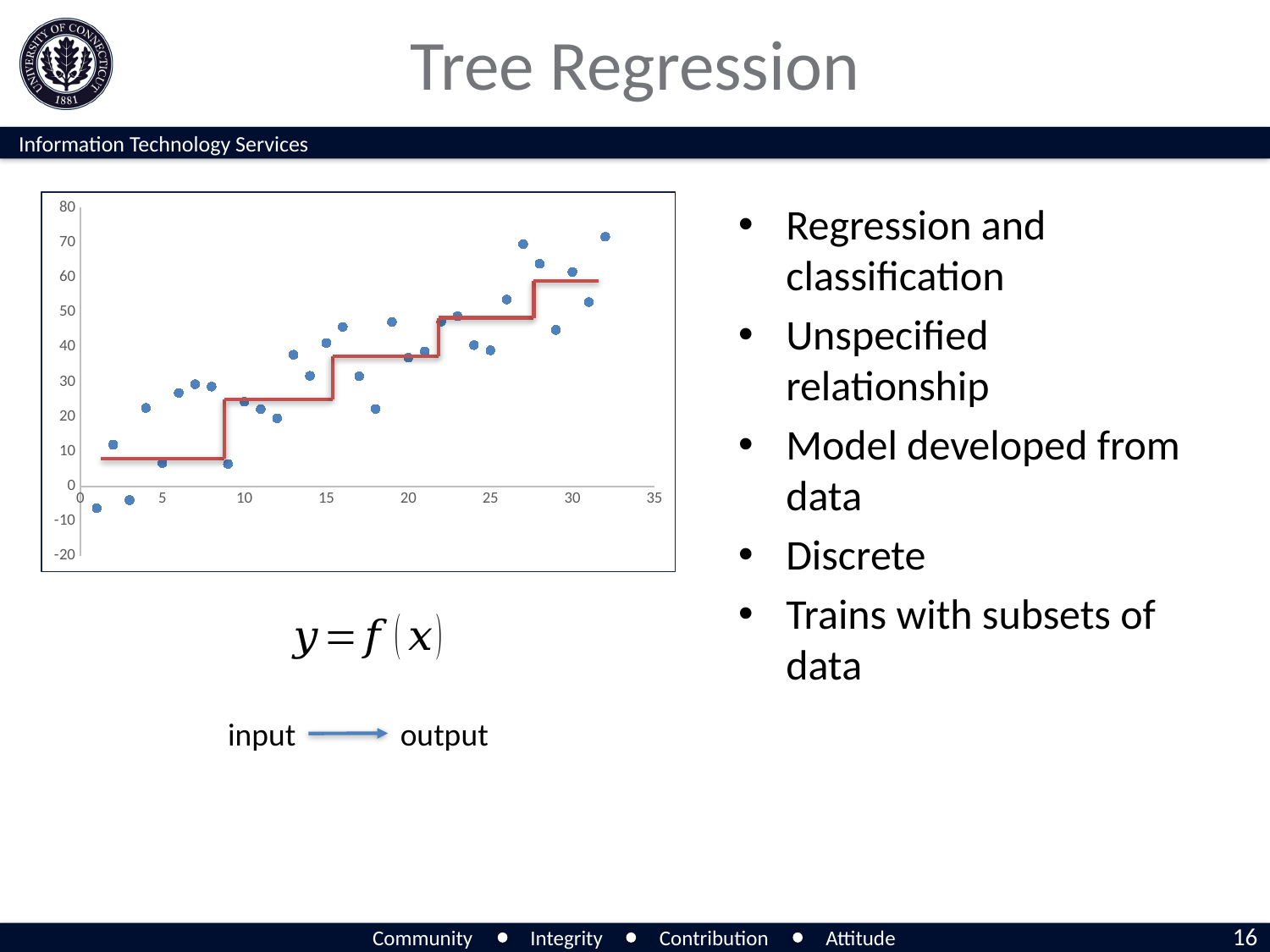
What is the highest tick value shown on the y axis? 80 What kind of chart is shown on the slide? scatter chart What colour is the step line drawn over the points? red Does the red step line rise or fall as x increases? rise Do the plotted points generally rise or fall as the x value increases? rise How many horizontal step levels does the red line have? 5 Is the highest plotted point greater or less than 60? greater Is the value of the last (rightmost) step of the red line greater or less than 50? greater Is the value of the first (leftmost) step of the red line greater or less than 20? less